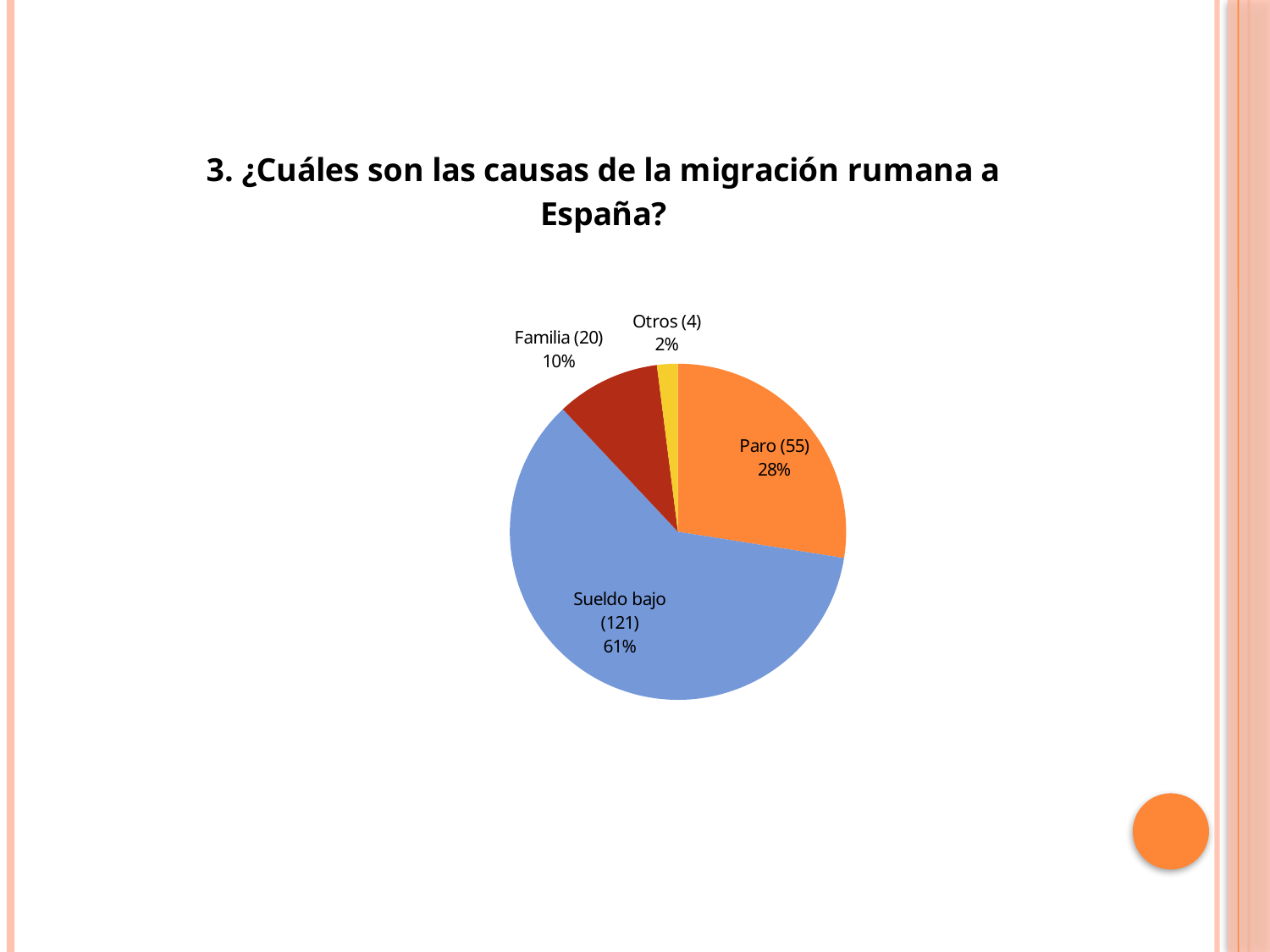
What percentage share does the Sueldo bajo slice have? 61% What kind of chart is shown on the slide? pie chart Which is larger, the Familia slice or the Paro slice? Paro What percentage share does the Familia slice have? 10% What percentage share does the Paro slice have? 28% What is the difference in count between Sueldo bajo (121) and Paro (55)? 66 Which category has the largest slice of the pie? Sueldo bajo How many categories are shown in the pie chart? 4 What count is shown in parentheses for Sueldo bajo? 121 What count is shown in parentheses for Paro? 55 Which category has the smallest slice of the pie? Otros